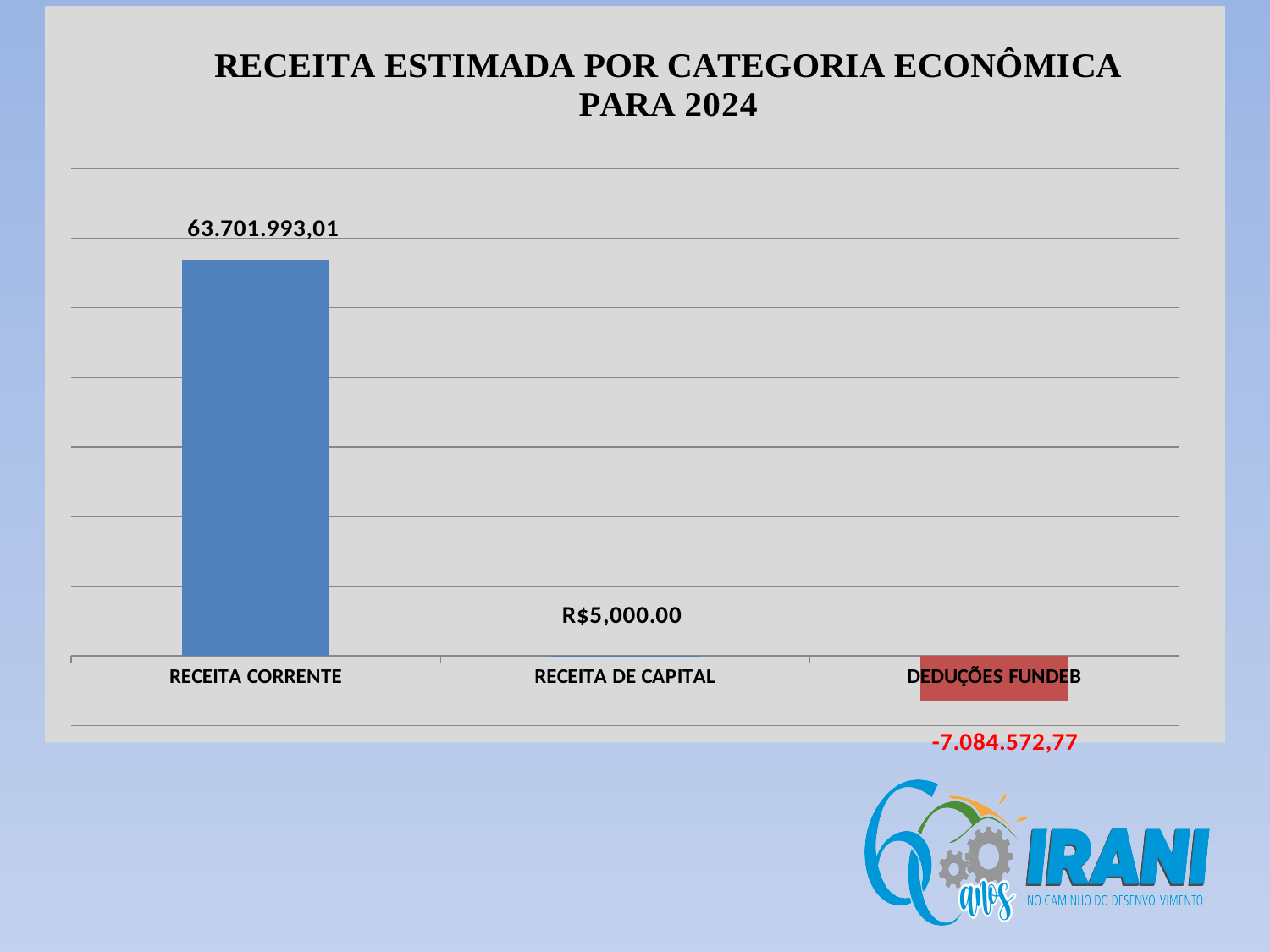
What colour is the bar for DEDUÇÕES FUNDEB? Red What is the value for RECEITA DE CAPITAL? R$5,000.00 What is the title of the chart? RECEITA ESTIMADA POR CATEGORIA ECONÔMICA PARA 2024 Which category has the lowest value? DEDUÇÕES FUNDEB What is the difference between the value for RECEITA CORRENTE and the value for DEDUÇÕES FUNDEB? 70.786.565,78 Which category has the highest value? RECEITA CORRENTE Do the values rise or fall from left to right along the x axis? Fall Which is larger, the value for RECEITA DE CAPITAL or the value for DEDUÇÕES FUNDEB? RECEITA DE CAPITAL What kind of chart is shown on the slide? Bar chart What is the value for RECEITA CORRENTE? 63.701.993,01 How many categories are shown on the x axis? 3 What is the value for DEDUÇÕES FUNDEB? -7.084.572,77